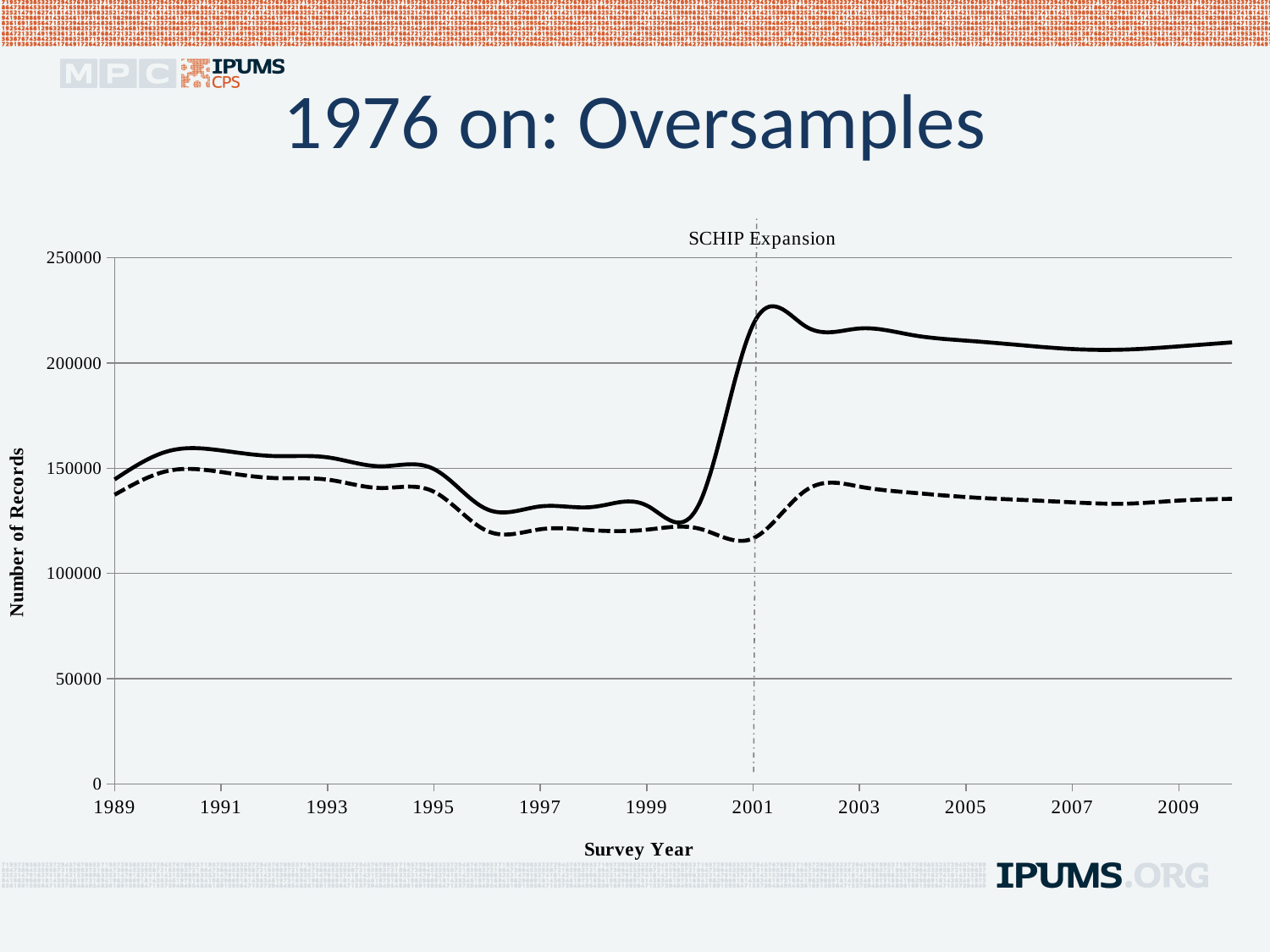
What kind of chart is shown on the slide? line chart Does the dashed line rise or fall between 1989 and 2001 overall? fall What is the label on the y-axis of the chart? Number of Records At which survey year is the vertical dash-dot line labelled 'SCHIP Expansion' placed? 2001 Is the value of the solid line in 1997 greater or less than 150000? less Does the solid line rise or fall between 1999 and 2001? rise Is the value of the dashed line in 2009 greater or less than 100000? greater Is the value of the dashed line in 2001 greater or less than 150000? less How many lines are plotted on the chart? 2 What is the title of the slide containing the chart? 1976 on: Oversamples In 2005, which line has the higher value, the solid line or the dashed line? the solid line